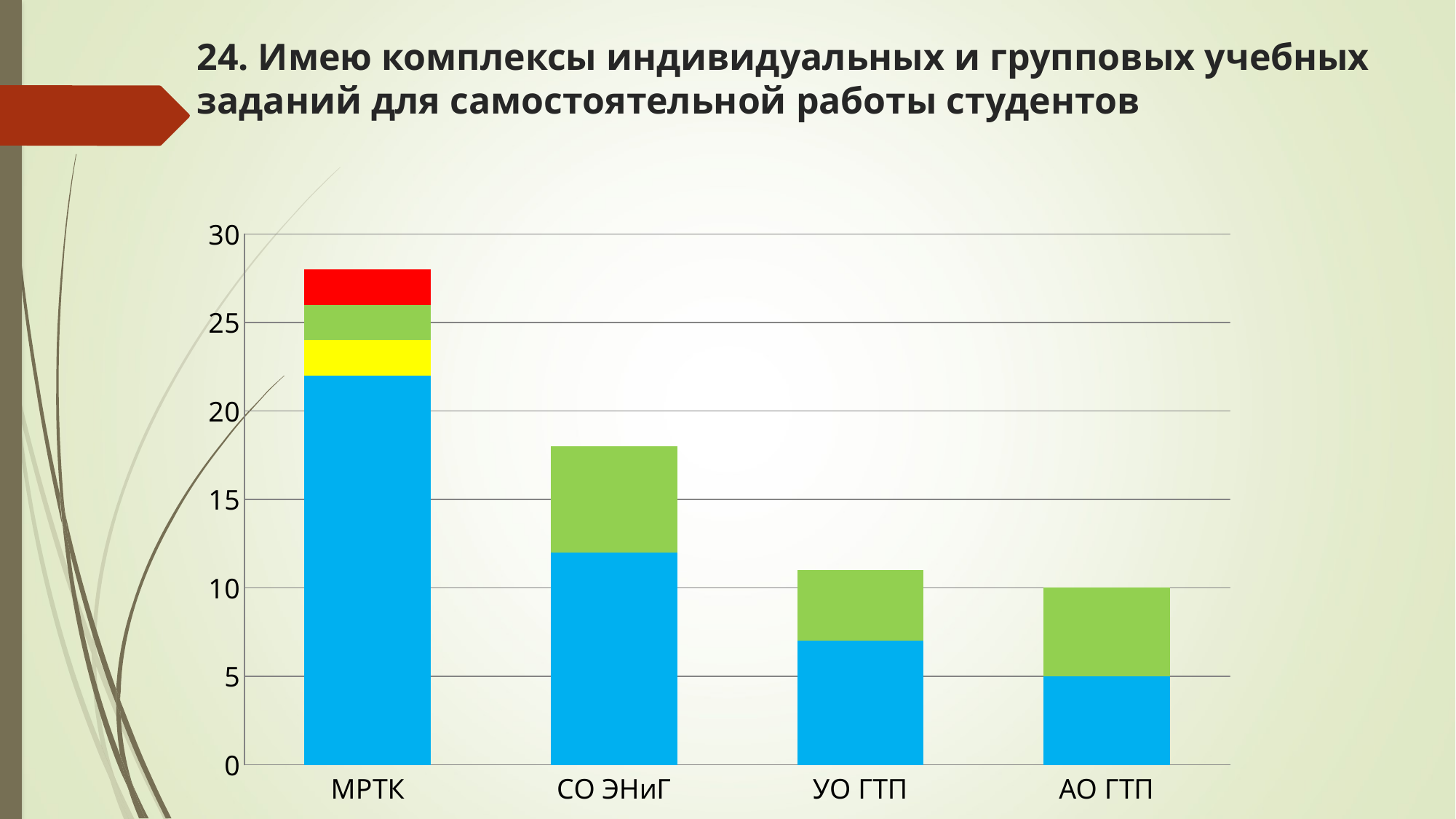
Is the blue segment of the СО ЭНиГ bar greater or less than 10? greater Which category has the tallest stacked bar? МРТК Which bar is taller, МРТК or СО ЭНиГ? МРТК Is the total height of the УО ГТП bar greater or less than 15? less Is the blue segment of the МРТК bar greater or less than 20? greater How many categories are shown on the x axis of the chart? 4 What kind of chart is shown on the slide? Stacked bar chart Do the bar totals rise or fall moving from left to right along the x axis? fall Which category has the shortest stacked bar? АО ГТП How many coloured segments does the МРТК bar contain? 4